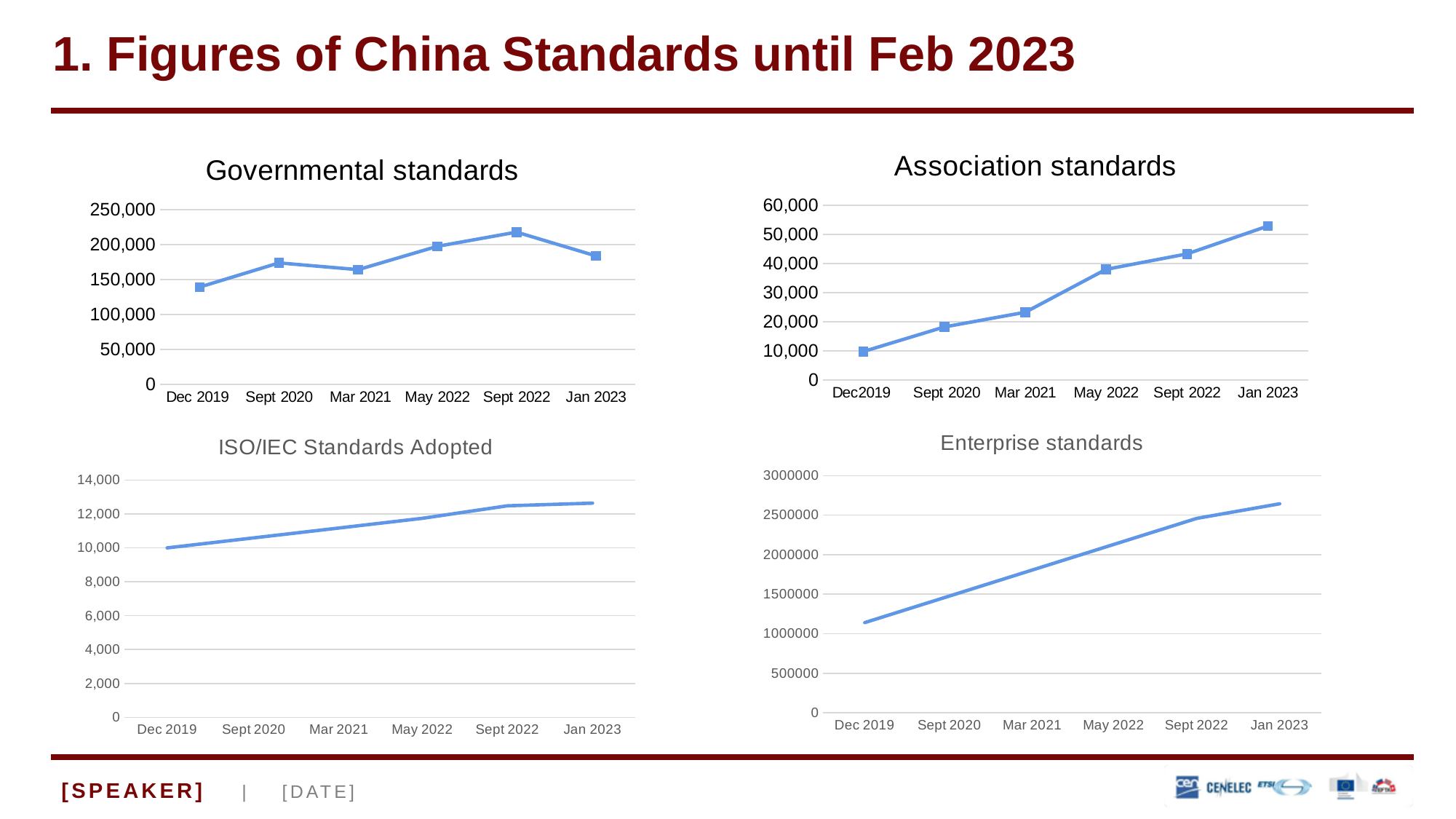
In the "ISO/IEC Standards Adopted" chart, is the value for Jan 2023 greater or less than 12,000? greater In the "Governmental standards" chart, is the value for Sept 2022 greater or less than 200,000? greater In the "Governmental standards" chart, is the value for Dec 2019 greater or less than 150,000? less How many data points are plotted in the "Association standards" chart? 6 In the "Governmental standards" chart, which date has the lowest value? Dec 2019 In the "Association standards" chart, which date has the highest value? Jan 2023 In the "Association standards" chart, do the values rise or fall from Dec2019 to Jan 2023? rise What kind of chart is the "Governmental standards" chart? line chart In the "Enterprise standards" chart, which is larger, the value for Sept 2022 or the value for Mar 2021? Sept 2022 In the "Governmental standards" chart, which date has the highest value? Sept 2022